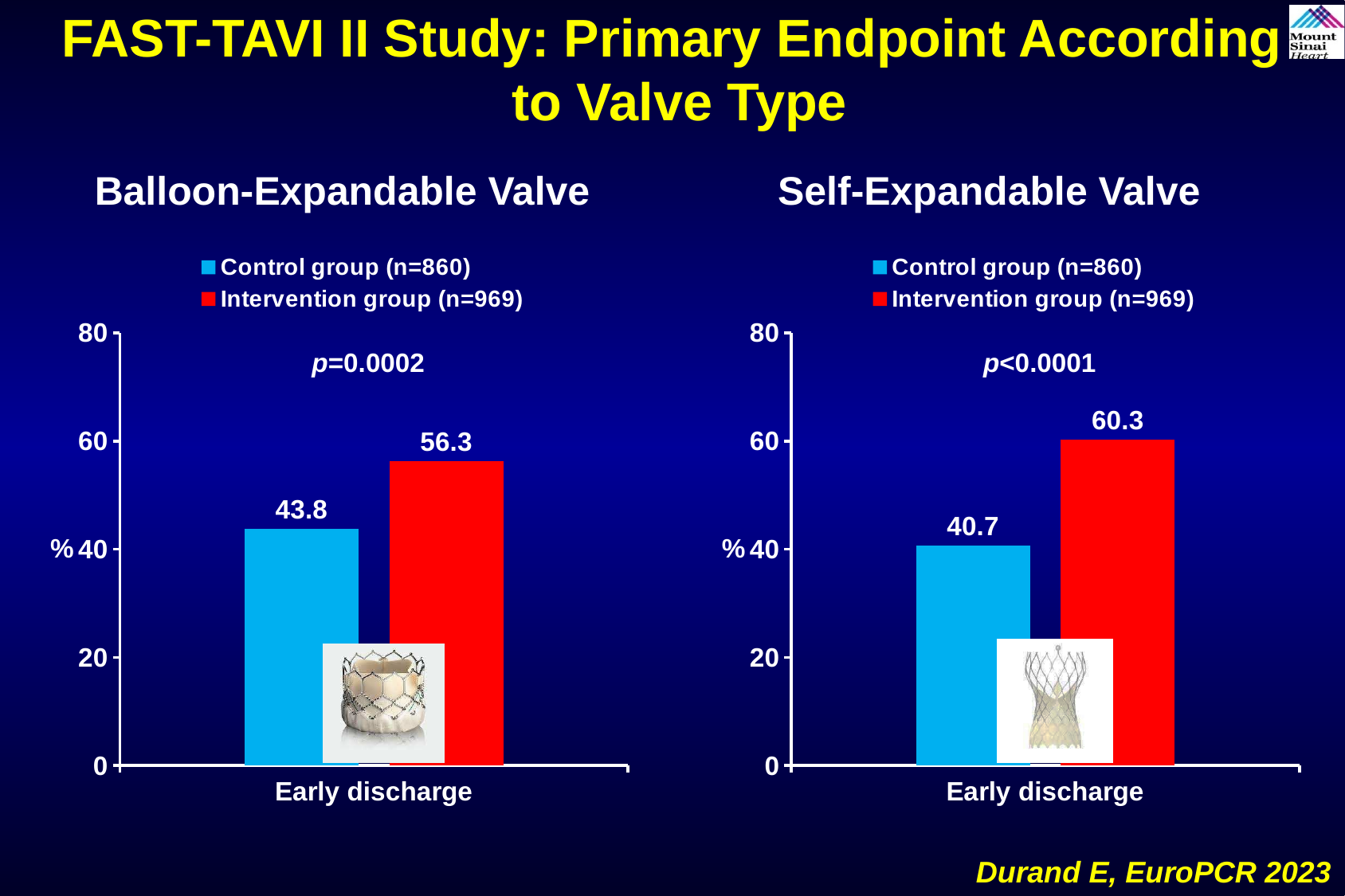
In the Balloon-Expandable Valve chart, what is the early discharge value for the Control group? 43.8 In the Self-Expandable Valve chart, what is the early discharge value for the Control group? 40.7 In the Self-Expandable Valve chart, which group has the higher early discharge value? Intervention group What p-value is shown on the Balloon-Expandable Valve chart? p=0.0002 In the Self-Expandable Valve chart, is the Intervention group value greater or less than 60? greater In the Self-Expandable Valve chart, what is the difference between the Intervention group and Control group values? 19.6 In the Balloon-Expandable Valve chart, what is the early discharge value for the Intervention group? 56.3 In the Balloon-Expandable Valve chart, which group has the lower early discharge value? Control group In the Self-Expandable Valve chart, what is the early discharge value for the Intervention group? 60.3 In the Balloon-Expandable Valve chart, what is the difference between the Intervention group and Control group values? 12.5 What kind of chart is the Self-Expandable Valve chart? Bar chart How many series does the legend of the Balloon-Expandable Valve chart list? 2